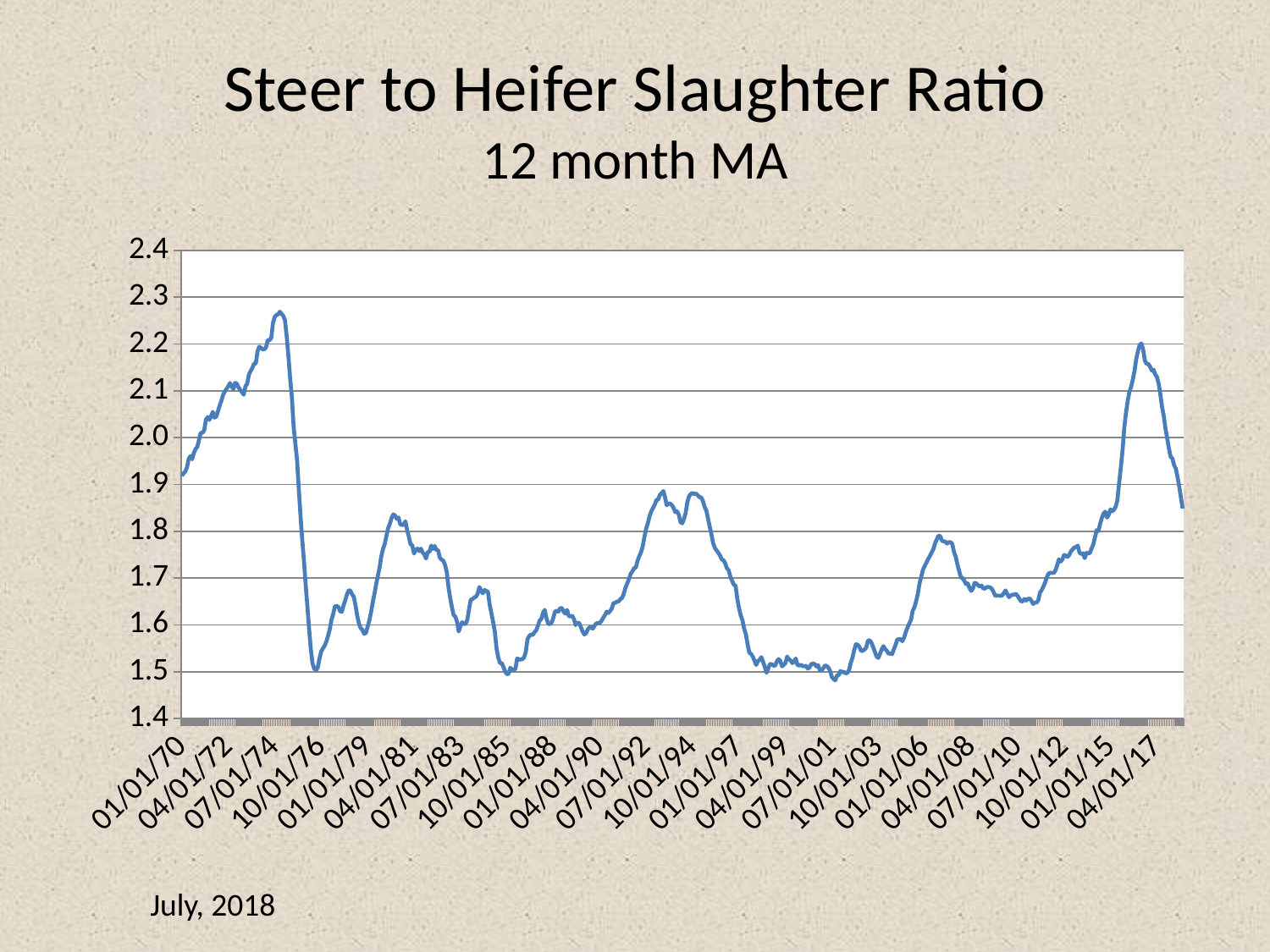
How many date labels are shown on the x axis? 22 What is the lowest value shown on the y axis? 1.4 Which is larger, the value at 07/01/74 or the value at 10/01/76? 07/01/74 Is the value at 07/01/01 greater or less than 1.6? less Does the line rise or fall between 07/01/74 and 10/01/76? fall Is the peak value of the line in the mid-1970s greater or less than 2.2? greater What is the title of the chart? Steer to Heifer Slaughter Ratio 12 month MA Is the value at 01/01/70 greater or less than 1.8? greater Does the line rise or fall between 01/01/70 and 07/01/74? rise What kind of chart is shown on the slide? line chart